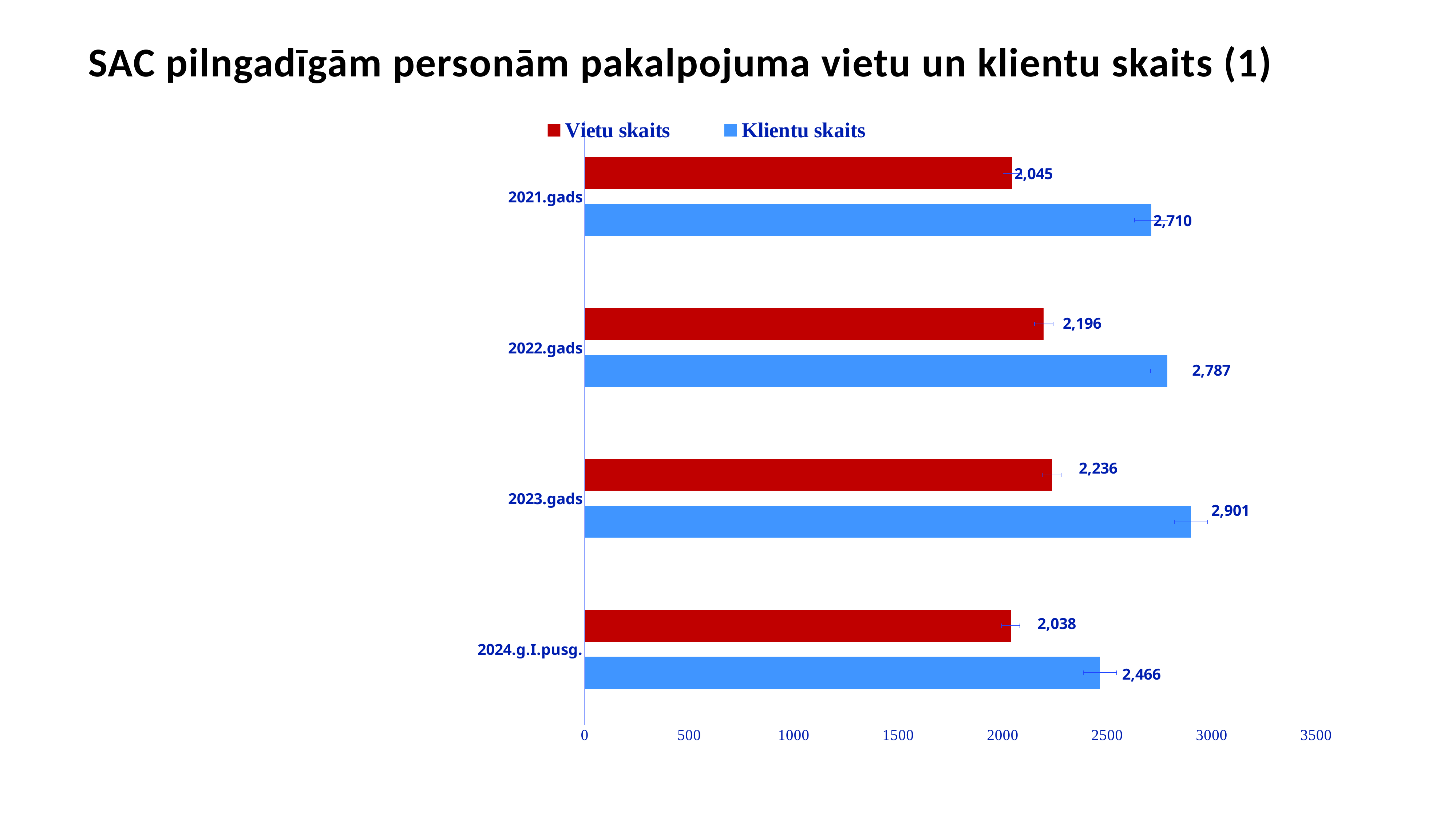
How many categories are shown on the chart? 4 Which is larger for 2023.gads: Vietu skaits or Klientu skaits? Klientu skaits Which category has the lowest Vietu skaits value? 2024.g.I.pusg. What kind of chart is shown on the slide? bar chart What is the difference between Klientu skaits and Vietu skaits for 2022.gads? 591 What is the value of Klientu skaits for 2024.g.I.pusg.? 2,466 Is the Klientu skaits value for 2021.gads greater or less than 2500? greater What is the value of Klientu skaits for 2023.gads? 2,901 What colour are the Vietu skaits bars? red Which category has the highest Klientu skaits value? 2023.gads What is the value of Vietu skaits for 2021.gads? 2,045 How many series does the legend list? 2